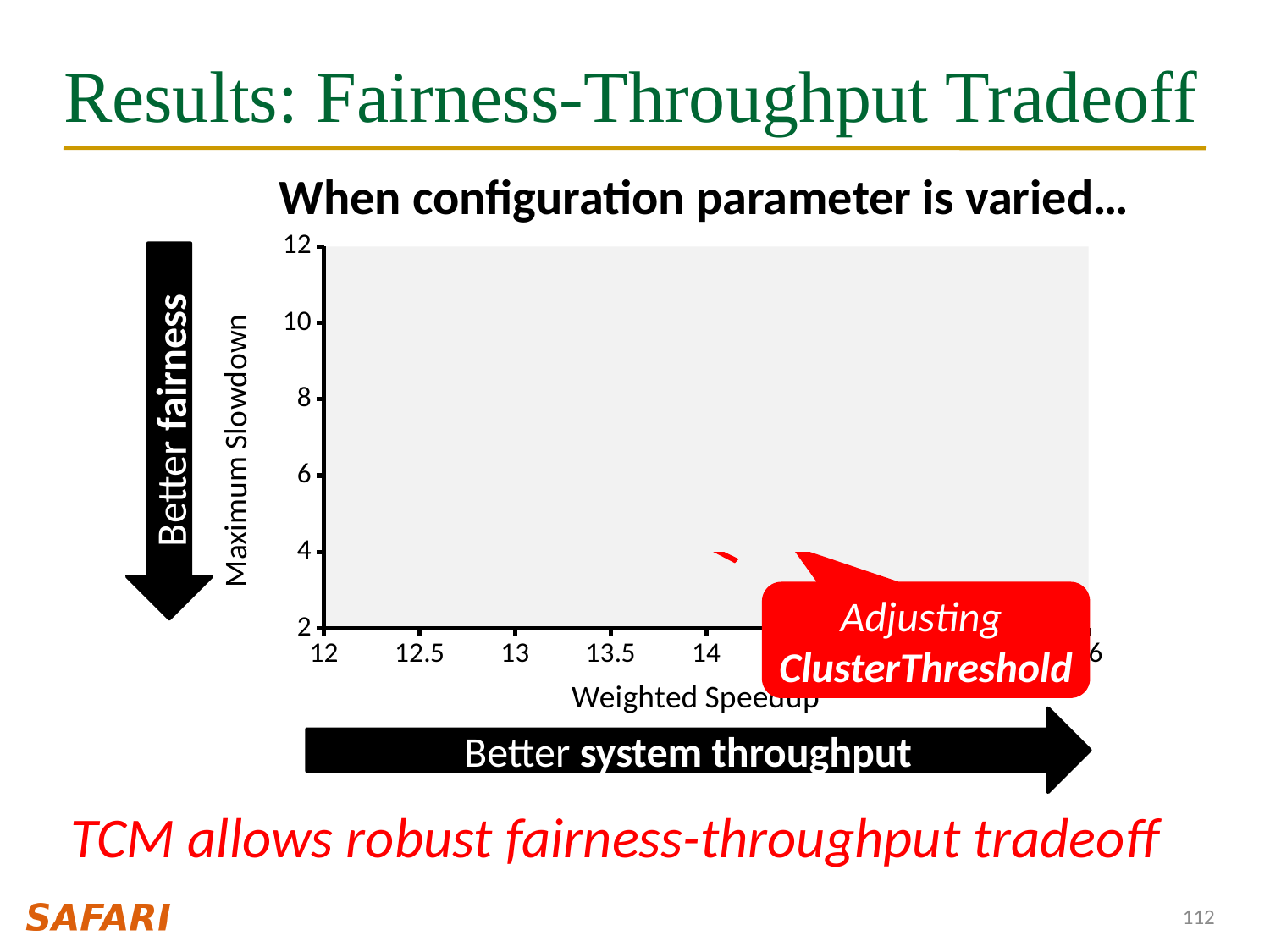
Is the Weighted Speedup of the visible red data point greater or less than 16? less What is the label on the vertical axis of the chart? Maximum Slowdown Is the Maximum Slowdown of the visible red data point greater or less than 2? greater What is the label on the horizontal axis of the chart? Weighted Speedup Is the Weighted Speedup of the visible red data point greater or less than 13? greater